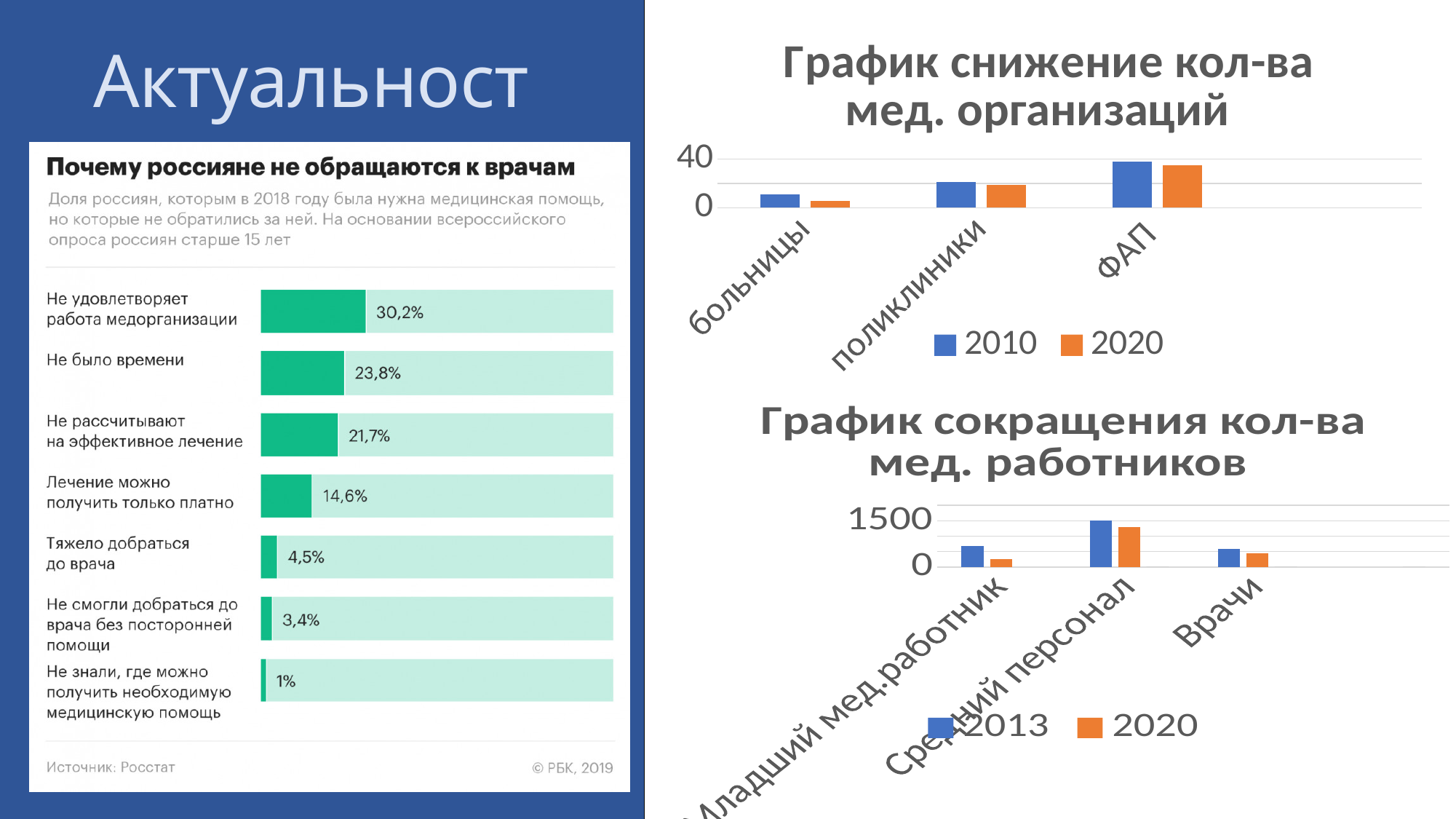
In the chart 'График сокращения кол-ва мед. работников', which category has the highest value for 2013? Средний персонал In the chart 'График сокращения кол-ва мед. работников', what years does the legend list? 2013 and 2020 In the chart 'График снижение кол-ва мед. организаций', for больницы, which is larger: 2010 or 2020? 2010 In the chart 'Почему россияне не обращаются к врачам', what is the difference between 'Не было времени' and 'Не рассчитывают на эффективное лечение'? 2,1% In the chart 'Почему россияне не обращаются к врачам', how many reasons are listed? 7 In the chart 'Почему россияне не обращаются к врачам', what is the value for 'Тяжело добраться до врача'? 4,5% In the chart 'График снижение кол-ва мед. организаций', which category has the highest value for 2010? ФАП In the chart 'Почему россияне не обращаются к врачам', what is the value for 'Не удовлетворяет работа медорганизации'? 30,2% In the chart 'Почему россияне не обращаются к врачам', which reason has the lowest share? Не знали, где можно получить необходимую медицинскую помощь In the chart 'График снижение кол-ва мед. организаций', is the 2010 value for поликлиники greater or less than 40? less What kind of chart is 'Почему россияне не обращаются к врачам'? bar chart In the chart 'График снижение кол-ва мед. организаций', how many series does the legend list? 2